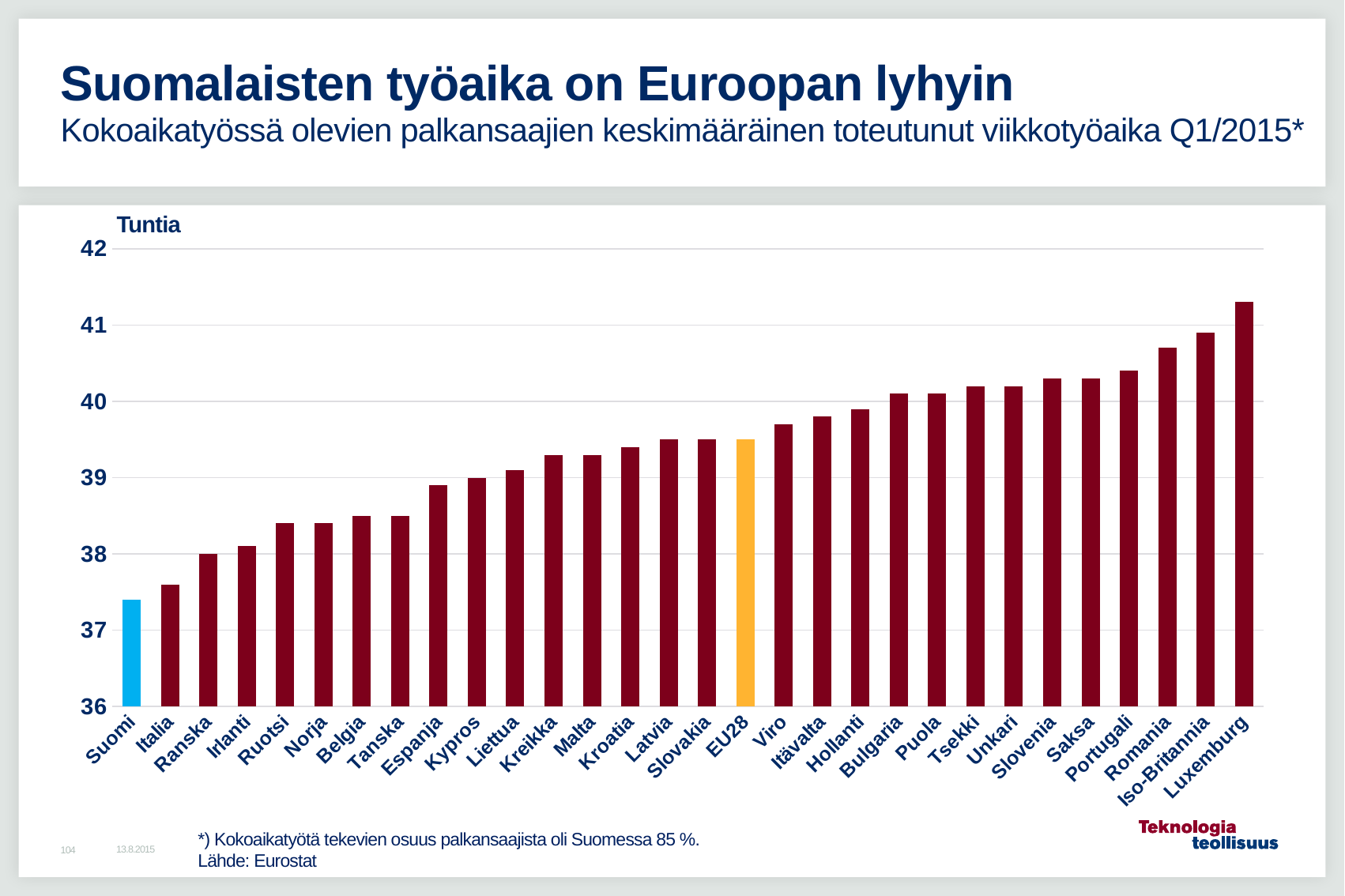
Do the values rise or fall moving from left to right along the x axis? rise Which country has the highest average weekly working time in the chart? Luxemburg Is the value for Luxemburg greater or less than 41? greater Is the value for Romania greater or less than 40? greater Which has a larger value, Saksa or Ruotsi? Saksa What kind of chart is shown on the slide? bar chart Which bar is coloured light blue in the chart? Suomi Is the value for EU28 greater or less than 40? less What unit is shown on the vertical axis label? Tuntia How many bars (categories) are plotted in the chart? 30 Which country has the lowest average weekly working time in the chart? Suomi